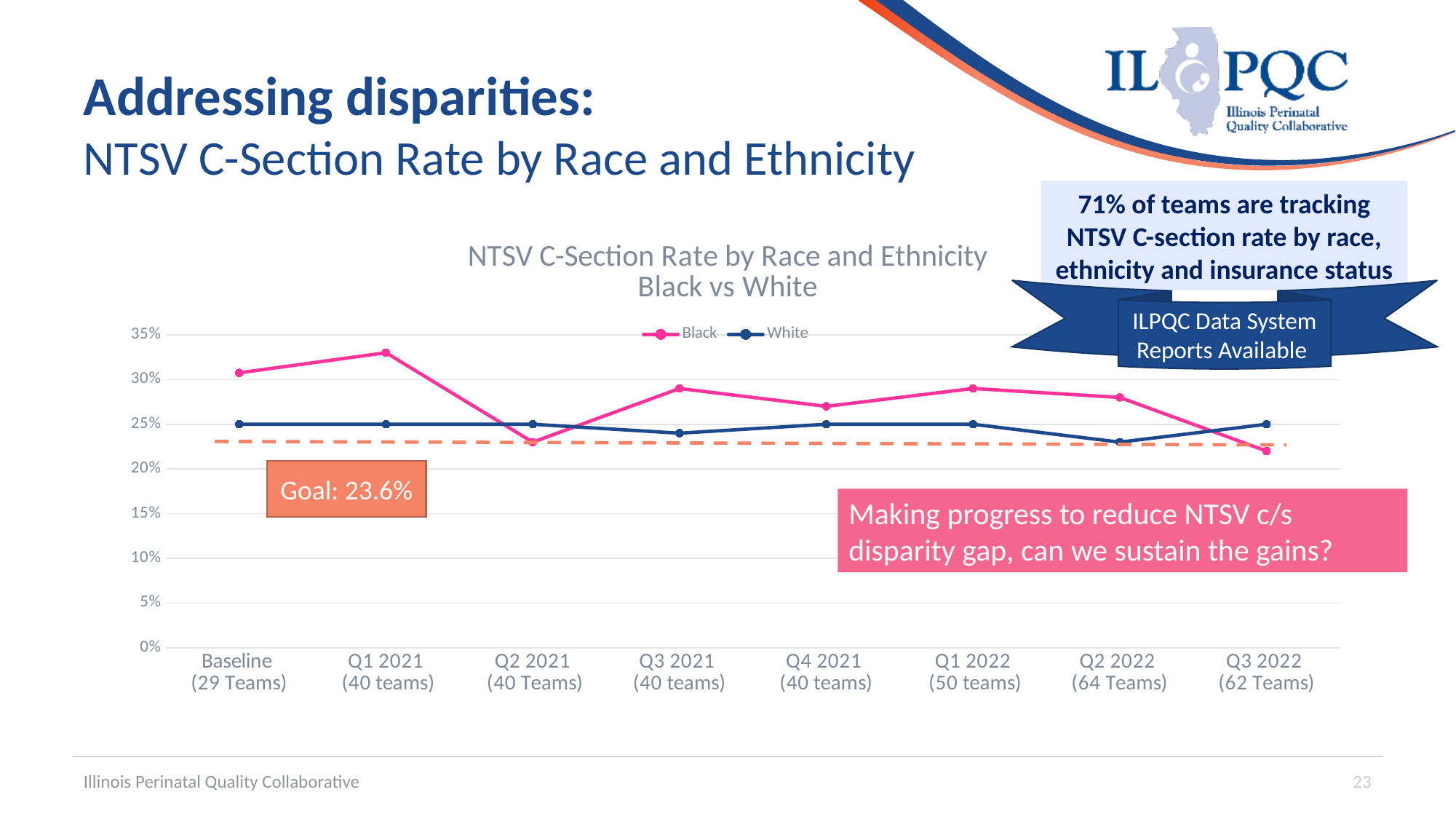
At which period is the Black NTSV C-section rate highest? Q1 2021 Which series is shown in pink? Black What goal value is shown in the box on the chart? 23.6% Is the White rate at Q2 2022 greater or less than 25%? less How many time periods are plotted along the x axis? 8 At Q1 2021, which series has the higher rate, Black or White? Black Is the Black rate at Q3 2022 greater or less than 25%? less At Q3 2022, which series has the higher rate, Black or White? White How many series does the chart legend list? 2 Does the Black rate rise or fall from Q1 2022 to Q3 2022? fall What kind of chart is shown on the slide? line chart Is the Black rate at Q1 2021 greater or less than 30%? greater